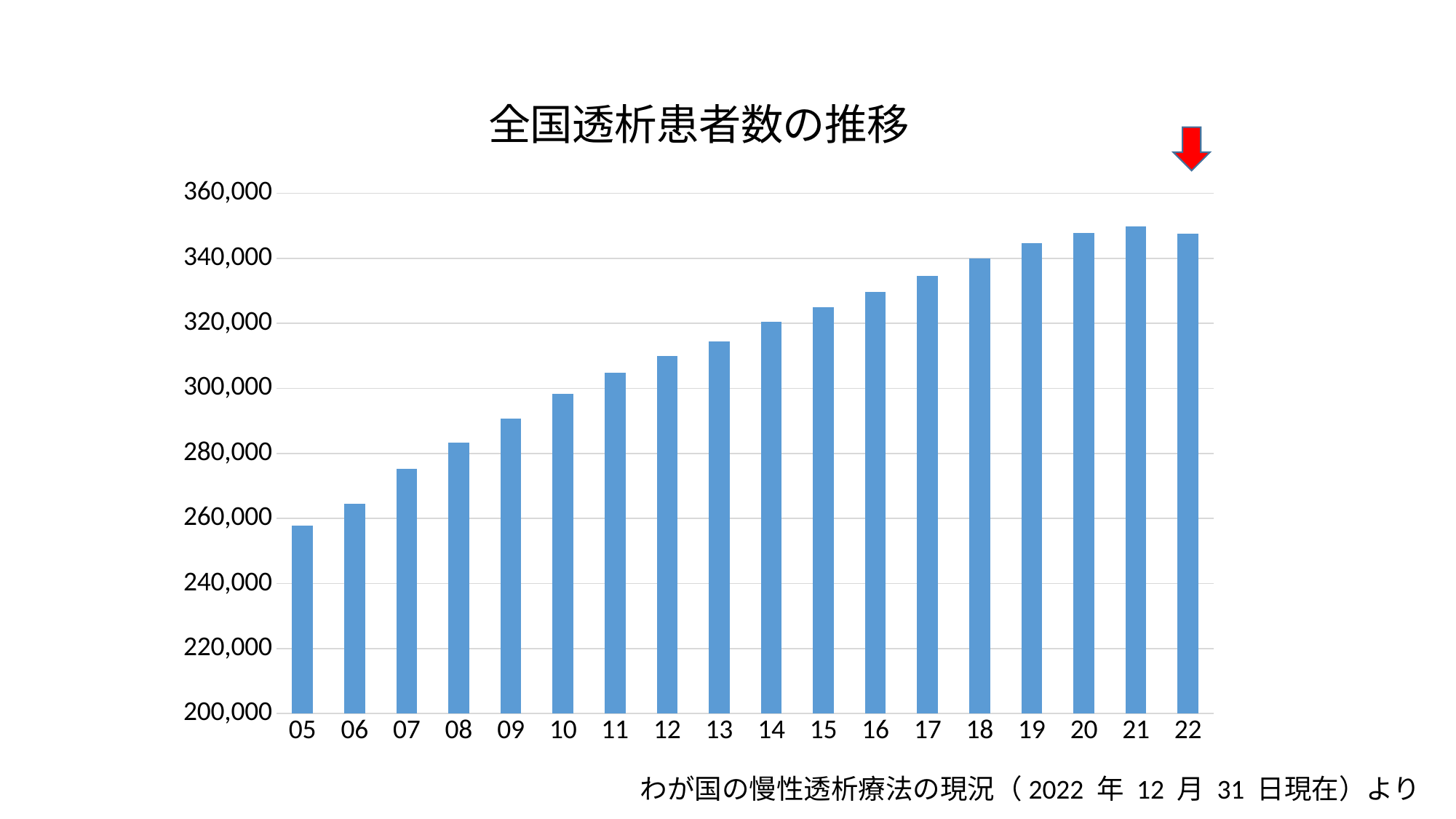
Is the value for 05 greater or less than 260,000? less What is the title of the chart? 全国透析患者数の推移 How many years (bars) are plotted on the chart? 18 Which year has the larger value, 10 or 15? 15 Is the value for 13 greater or less than 320,000? less Is the value for 20 greater or less than 340,000? greater Which year does the red arrow above the chart point to? 22 What kind of chart is shown on the slide? bar chart Do the values generally rise or fall from 05 to 21? rise Which year has the lowest number of dialysis patients? 05